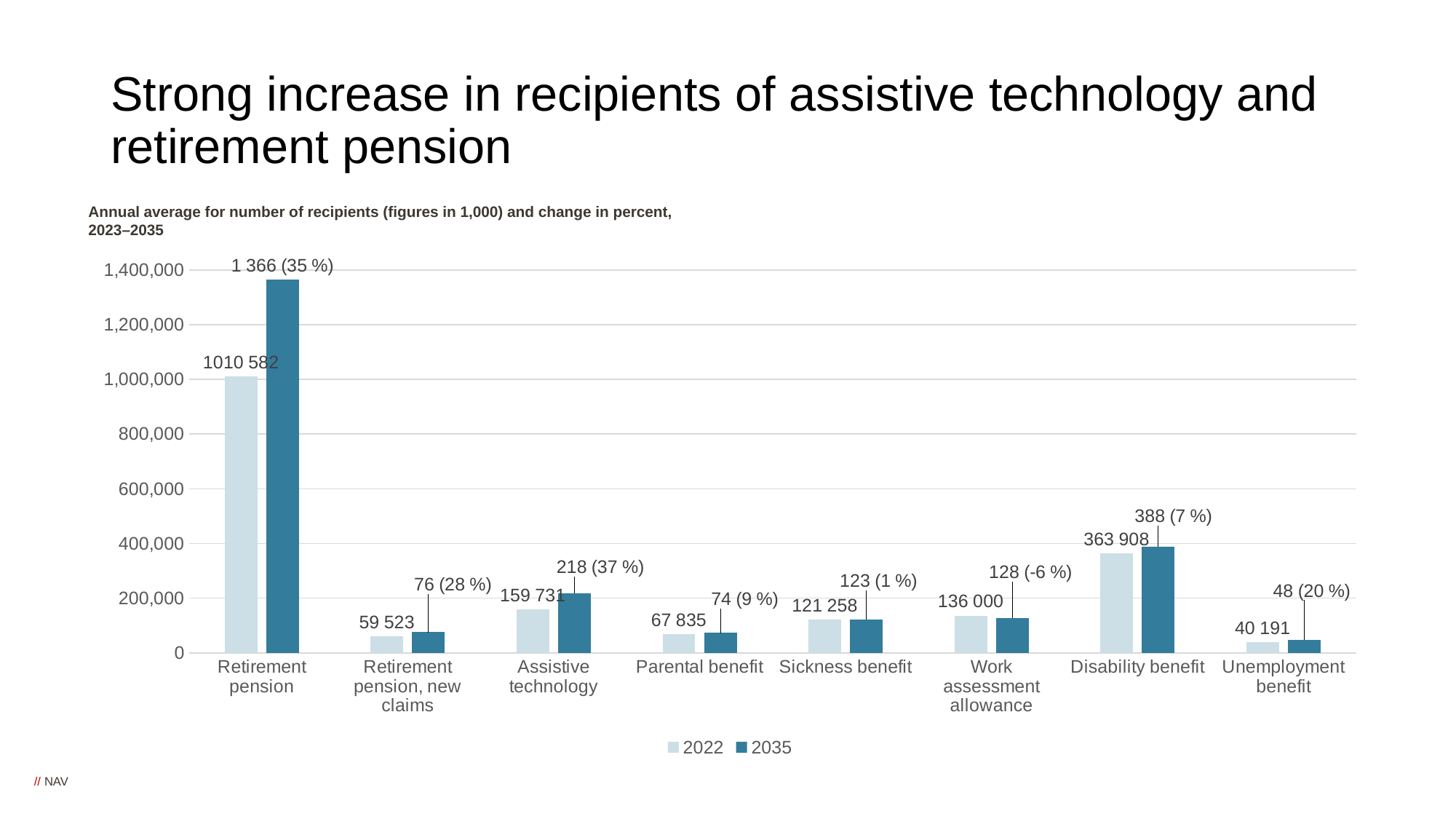
How many series does the legend list? 2 How many categories are shown on the x axis? 8 Is the 2035 bar for Retirement pension greater or less than 1,200,000? greater What is the data label on the 2035 bar for Assistive technology? 218 (37 %) What kind of chart is shown on the slide? Bar chart Which has the larger 2022 value, Sickness benefit or Work assessment allowance? Work assessment allowance What is the data label on the 2035 bar for Work assessment allowance? 128 (-6 %) What is the 2022 value labelled for Retirement pension? 1010 582 What are the two entries in the legend? 2022 and 2035 What is the 2022 value labelled for Disability benefit? 363 908 Which category has the lowest 2022 value? Unemployment benefit Which category has the highest 2022 value? Retirement pension